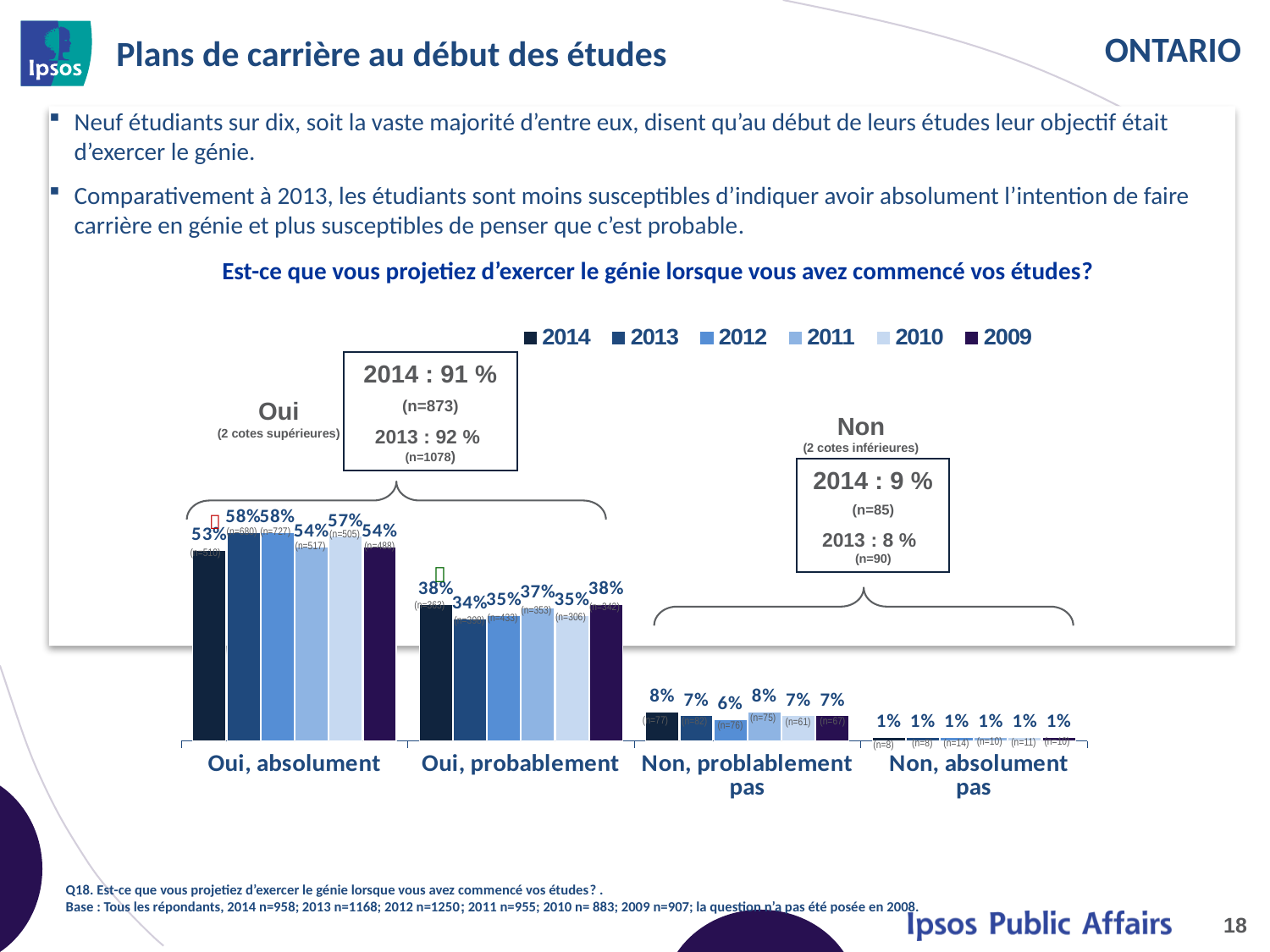
What is the value for 2014 in the 'Oui, absolument' category? 53% What is the difference between the 2013 and 2014 values in the 'Oui, absolument' category? 5% Which category has the lowest value for 2013? Non, absolument pas What is the first series listed in the legend? 2014 What is the value for 2012 in the 'Non, problablement pas' category? 6% How many series does the legend list? 6 In the 'Oui, probablement' category, which is larger: the 2014 value or the 2013 value? 2014 What kind of chart is shown on the slide? bar chart Which category has the highest value for 2014? Oui, absolument What is the value for 2013 in the 'Oui, probablement' category? 34% How many categories are shown on the x axis? 4 What is the value for 2009 in the 'Non, absolument pas' category? 1%